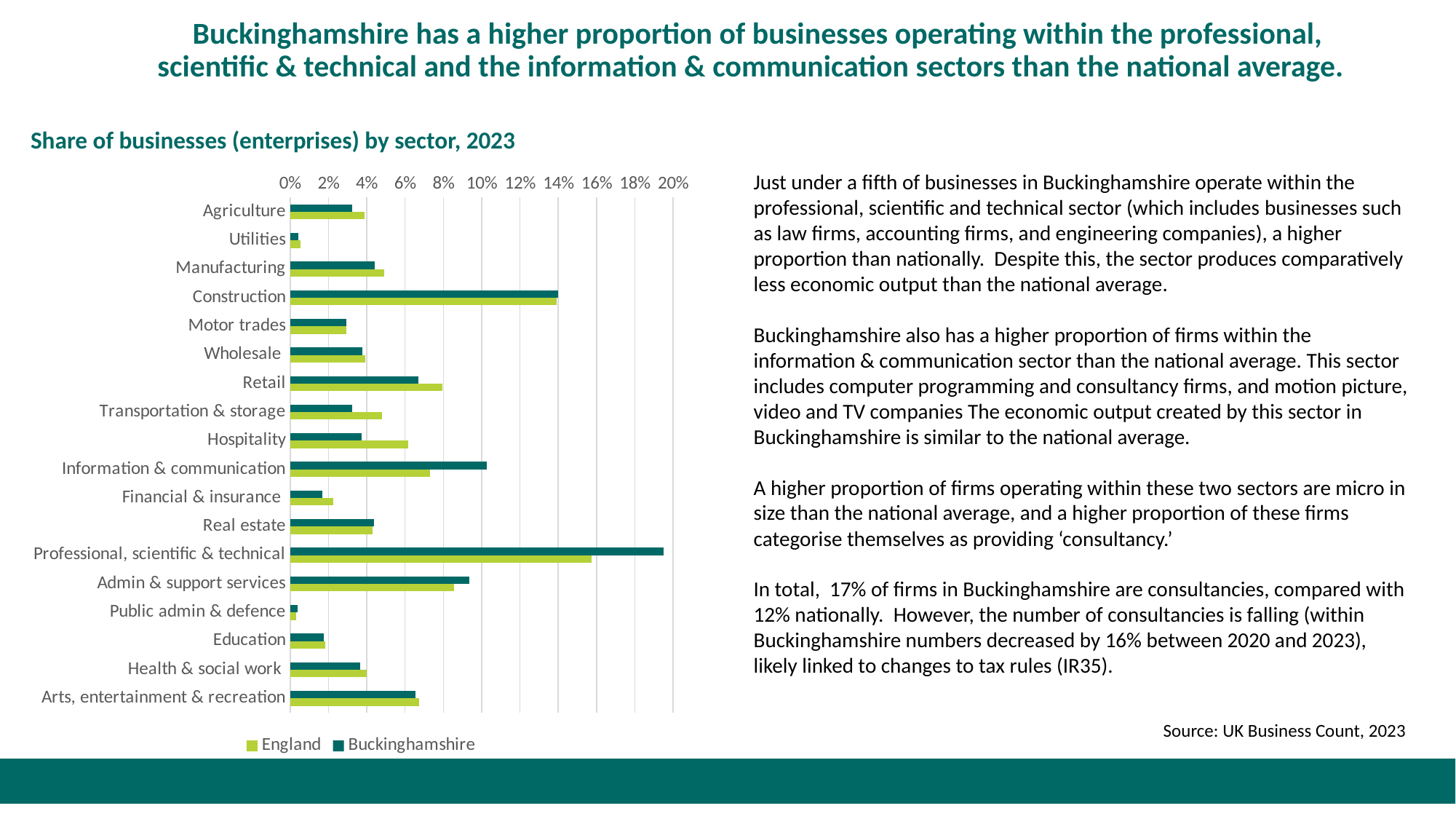
Is the Buckinghamshire value for Professional, scientific & technical greater or less than 18%? greater For Transportation & storage, which is larger: England or Buckinghamshire? England How many sectors are shown on the chart? 18 How many series does the chart legend list? 2 What is the title of the chart? Share of businesses (enterprises) by sector, 2023 For Information & communication, which is larger: England or Buckinghamshire? Buckinghamshire Which sector has the highest share of businesses for England? Professional, scientific & technical What kind of chart is shown on the slide? bar chart Which sector has the highest share of businesses for Buckinghamshire? Professional, scientific & technical Is the Buckinghamshire value for Information & communication greater or less than 8%? greater Is the Buckinghamshire value for Financial & insurance greater or less than 2%? less For Hospitality, which is larger: England or Buckinghamshire? England